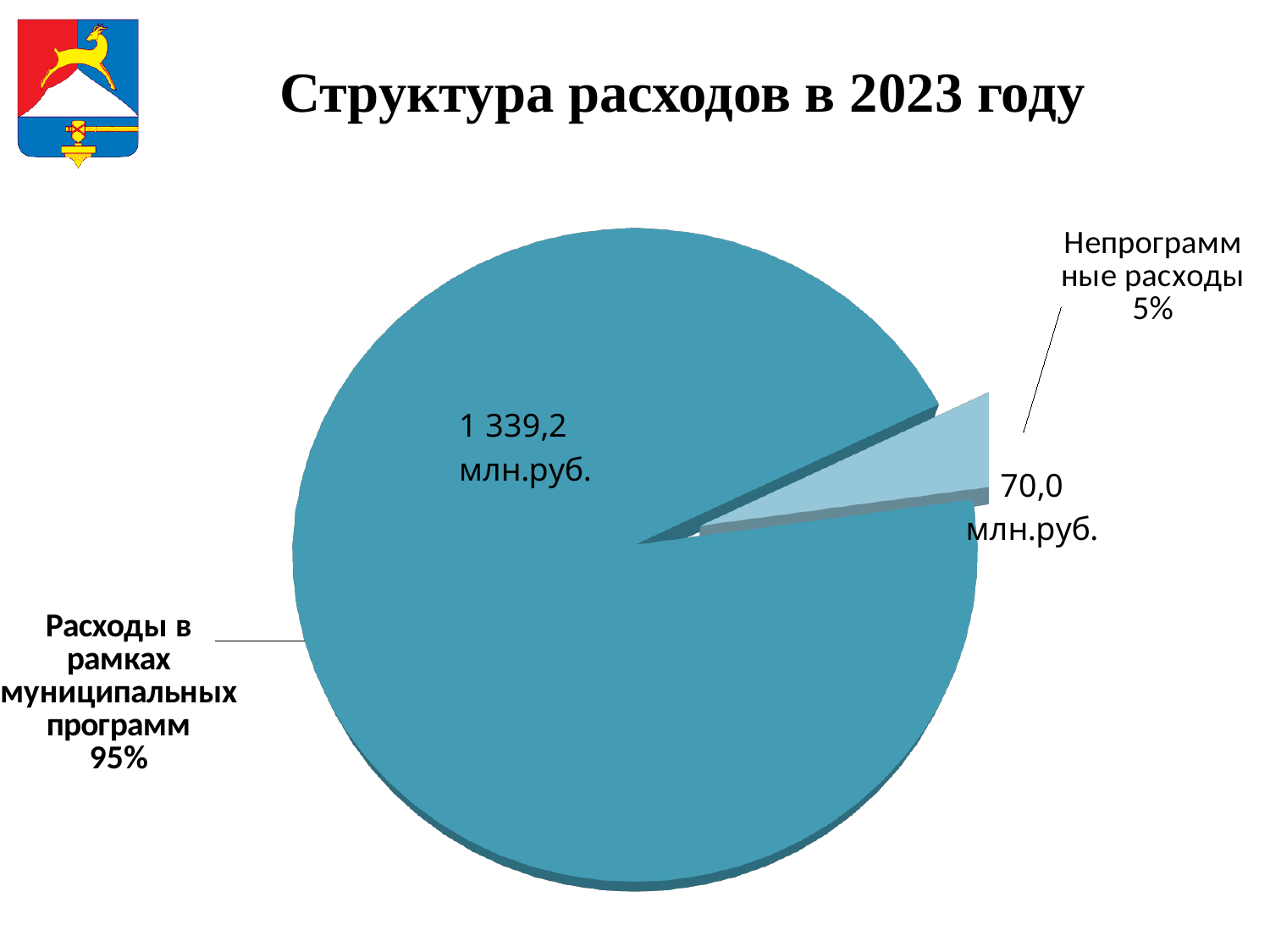
Which slice is the largest? Расходы в рамках муниципальных программ What is the value for Непрограммные расходы? 70,0 млн.руб. Which is larger: Расходы в рамках муниципальных программ or Непрограммные расходы? Расходы в рамках муниципальных программ What is the title of the chart? Структура расходов в 2023 году What share of the pie is Расходы в рамках муниципальных программ? 95% How many slices does the pie chart have? 2 What kind of chart is shown on the slide? pie chart What is the difference between Расходы в рамках муниципальных программ and Непрограммные расходы in млн.руб.? 1 269,2 млн.руб. Which slice is the smallest? Непрограммные расходы What is the value for Расходы в рамках муниципальных программ? 1 339,2 млн.руб. What is the total of the two slices in млн.руб.? 1 409,2 млн.руб. What share of the pie is Непрограммные расходы? 5%